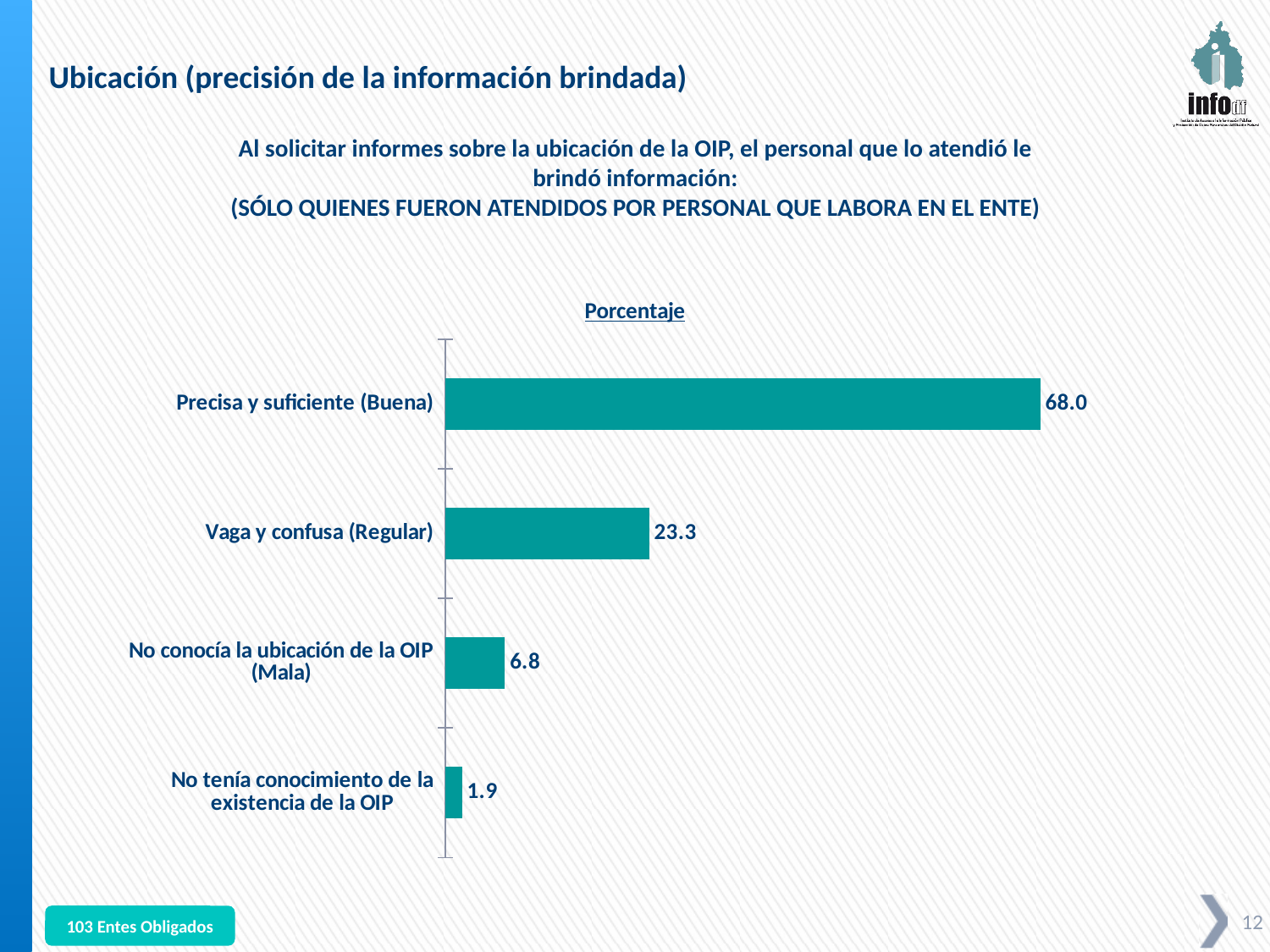
What is the value for "No conocía la ubicación de la OIP (Mala)"? 6.8 Which category has the highest value? Precisa y suficiente (Buena) What kind of chart is shown on the slide? Bar chart Which category has the lowest value? No tenía conocimiento de la existencia de la OIP What is the difference between the values for "Precisa y suficiente (Buena)" and "Vaga y confusa (Regular)"? 44.7 How many categories are shown in the chart? 4 What is the value for "Vaga y confusa (Regular)"? 23.3 What is the value for "No tenía conocimiento de la existencia de la OIP"? 1.9 What is the difference between the values for "No conocía la ubicación de la OIP (Mala)" and "No tenía conocimiento de la existencia de la OIP"? 4.9 What is the title shown above the chart? Porcentaje What is the value for "Precisa y suficiente (Buena)"? 68.0 Which is larger, the value for "Vaga y confusa (Regular)" or the value for "No conocía la ubicación de la OIP (Mala)"? Vaga y confusa (Regular)